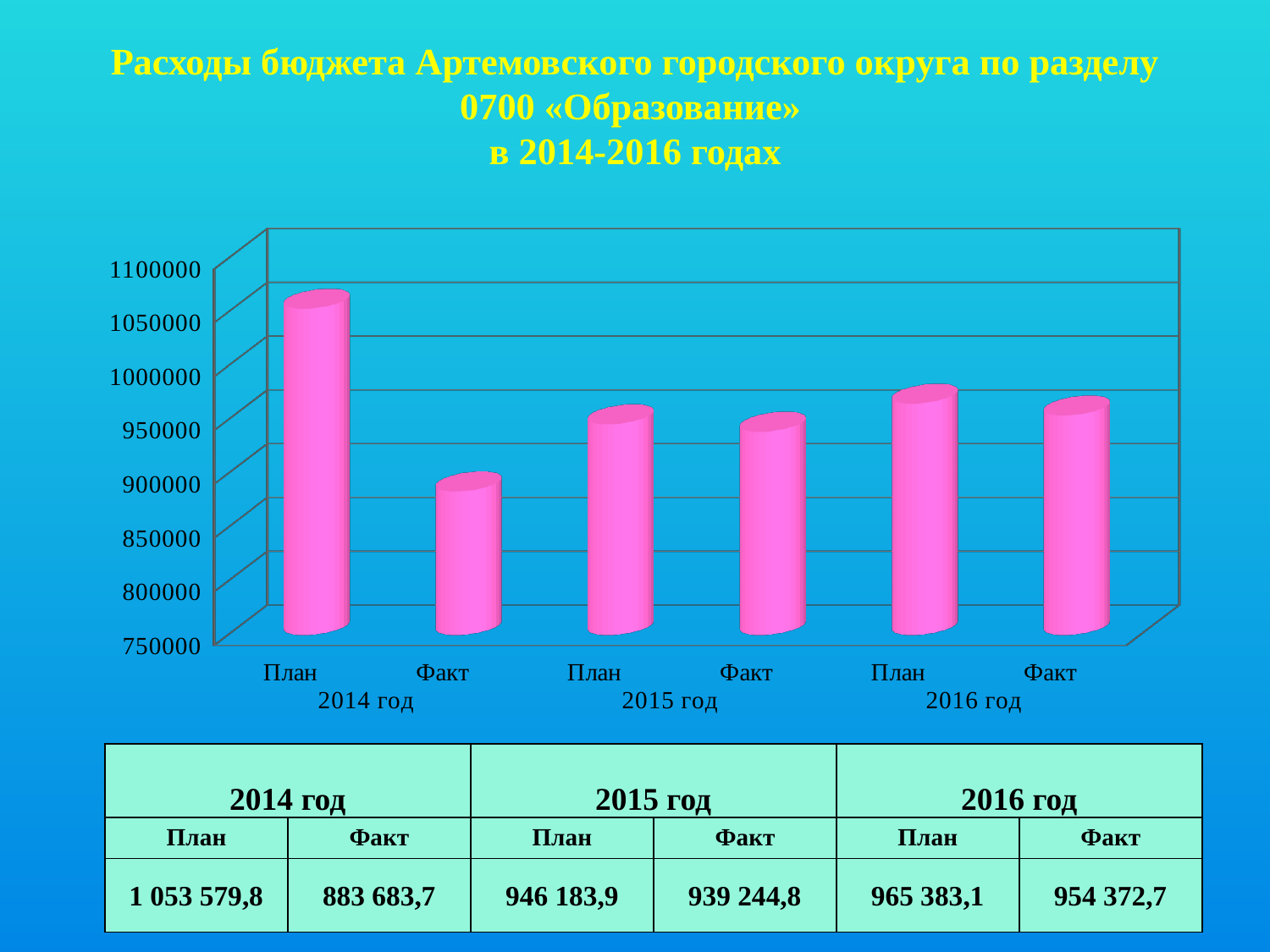
What kind of chart is shown on the slide? bar chart Do the Факт values rise or fall from 2014 год to 2016 год? rise How many bars are plotted in the chart? 6 What is the difference between План and Факт for 2016 год? 11 010,4 What is the value of Факт for 2015 год? 939 244,8 Which bar has the lowest value? Факт 2014 год What is the value of План for 2016 год? 965 383,1 Is the value for Факт 2014 год greater or less than 900000? less What is the value of План for 2014 год? 1 053 579,8 Which is larger: План for 2016 год or Факт for 2014 год? План for 2016 год Which bar has the highest value? План 2014 год What is the difference between План and Факт for 2014 год? 169 896,1